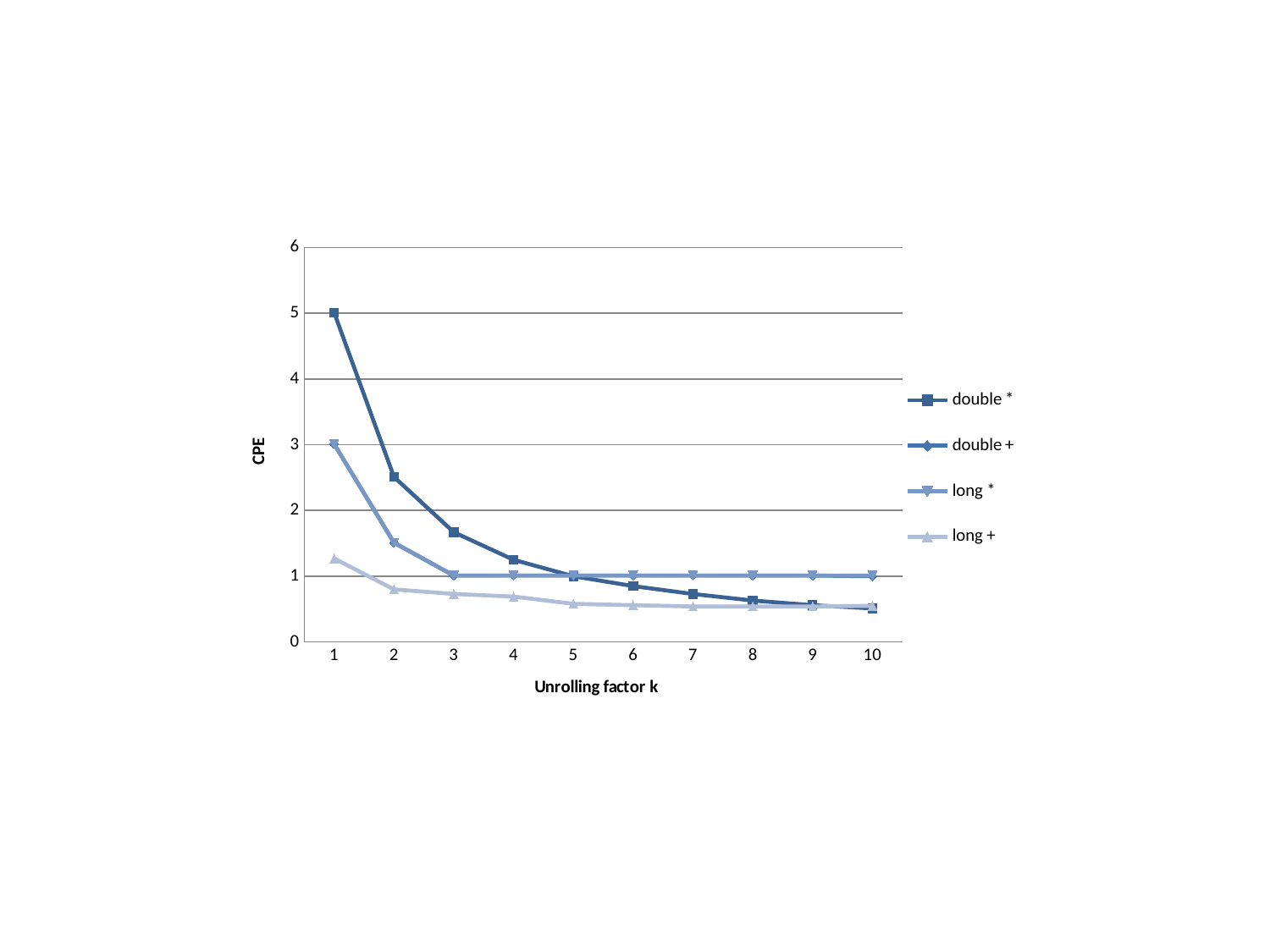
Is the CPE for the long + series at k = 1 greater or less than 2? less What is the title of the x axis? Unrolling factor k Which series has the lowest CPE at unrolling factor k = 1? long + What kind of chart is shown on the slide? line chart Does the CPE for the double * series rise or fall as the unrolling factor k increases? falls How many series does the legend list? 4 What is the title of the y axis? CPE Which series has the highest CPE at unrolling factor k = 1? double * How many unrolling factor values are plotted along the x axis? 10 Is the CPE for the double * series at k = 2 greater or less than 2? greater Is the CPE for the double * series at k = 10 greater or less than 1? less What is the CPE for the double * series at unrolling factor k = 1? 5